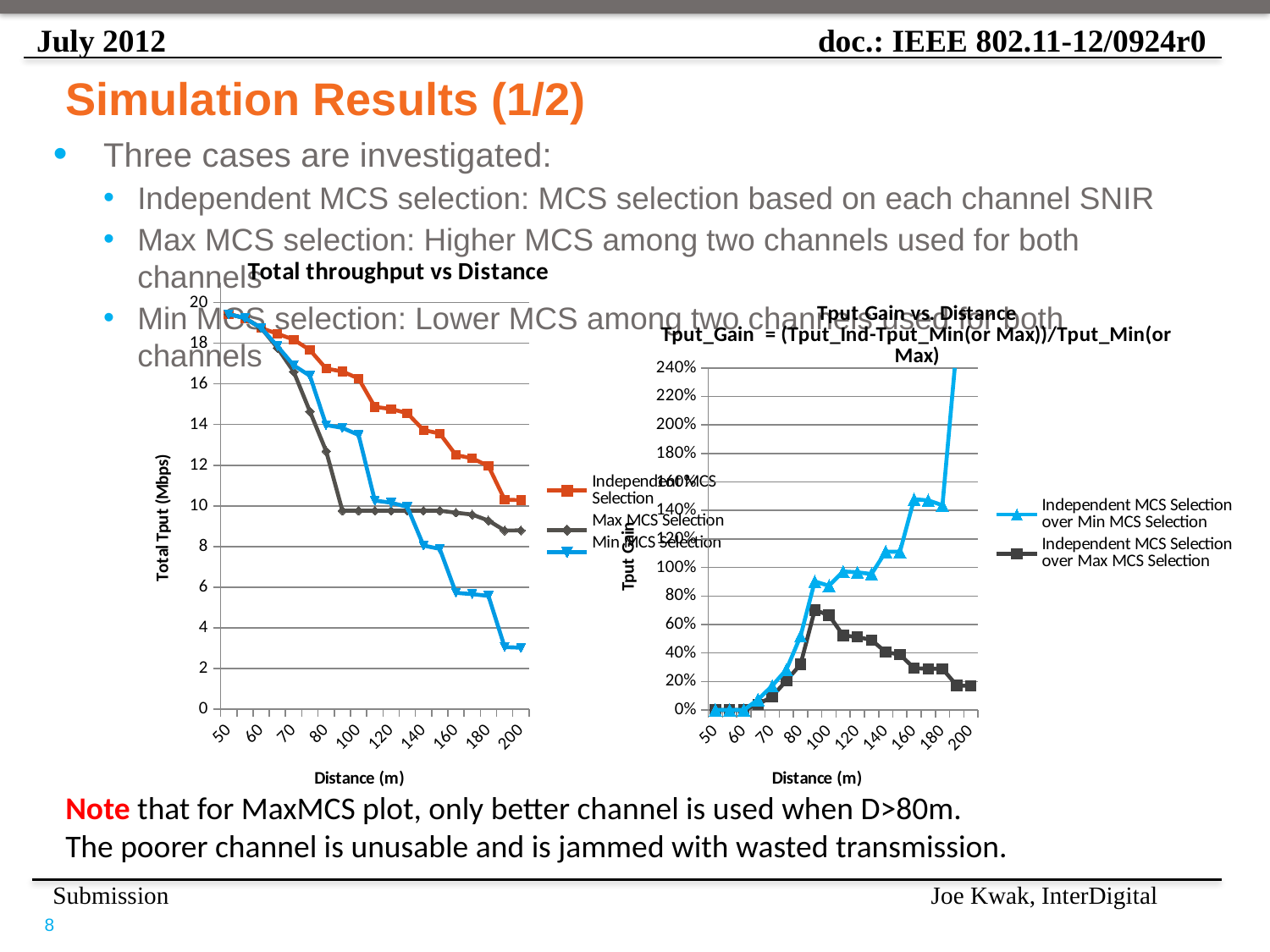
In the 'Total throughput vs Distance' chart, is the value for Max MCS Selection at 100 m greater or less than 12? less What is the y-axis label of the 'Total throughput vs Distance' chart? Total Tput (Mbps) In the 'Tput Gain vs Distance' chart, which series has the larger value at 150 m: 'Independent MCS Selection over Min MCS Selection' or 'Independent MCS Selection over Max MCS Selection'? Independent MCS Selection over Min MCS Selection In the 'Total throughput vs Distance' chart, is the value for Min MCS Selection at 200 m greater or less than 4? less What kind of chart is the 'Total throughput vs Distance' chart? line chart In the 'Total throughput vs Distance' chart, is the value for Independent MCS Selection at 100 m greater or less than 14? greater In the 'Total throughput vs Distance' chart, which series has the larger value at 200 m: Independent MCS Selection or Min MCS Selection? Independent MCS Selection In the 'Total throughput vs Distance' chart, do the values for Min MCS Selection rise or fall as distance increases? fall How many series does the legend of the 'Tput Gain vs Distance' chart list? 2 In the 'Tput Gain vs Distance' chart, does the 'Independent MCS Selection over Min MCS Selection' series rise or fall as distance increases? rise How many series does the legend of the 'Total throughput vs Distance' chart list? 3